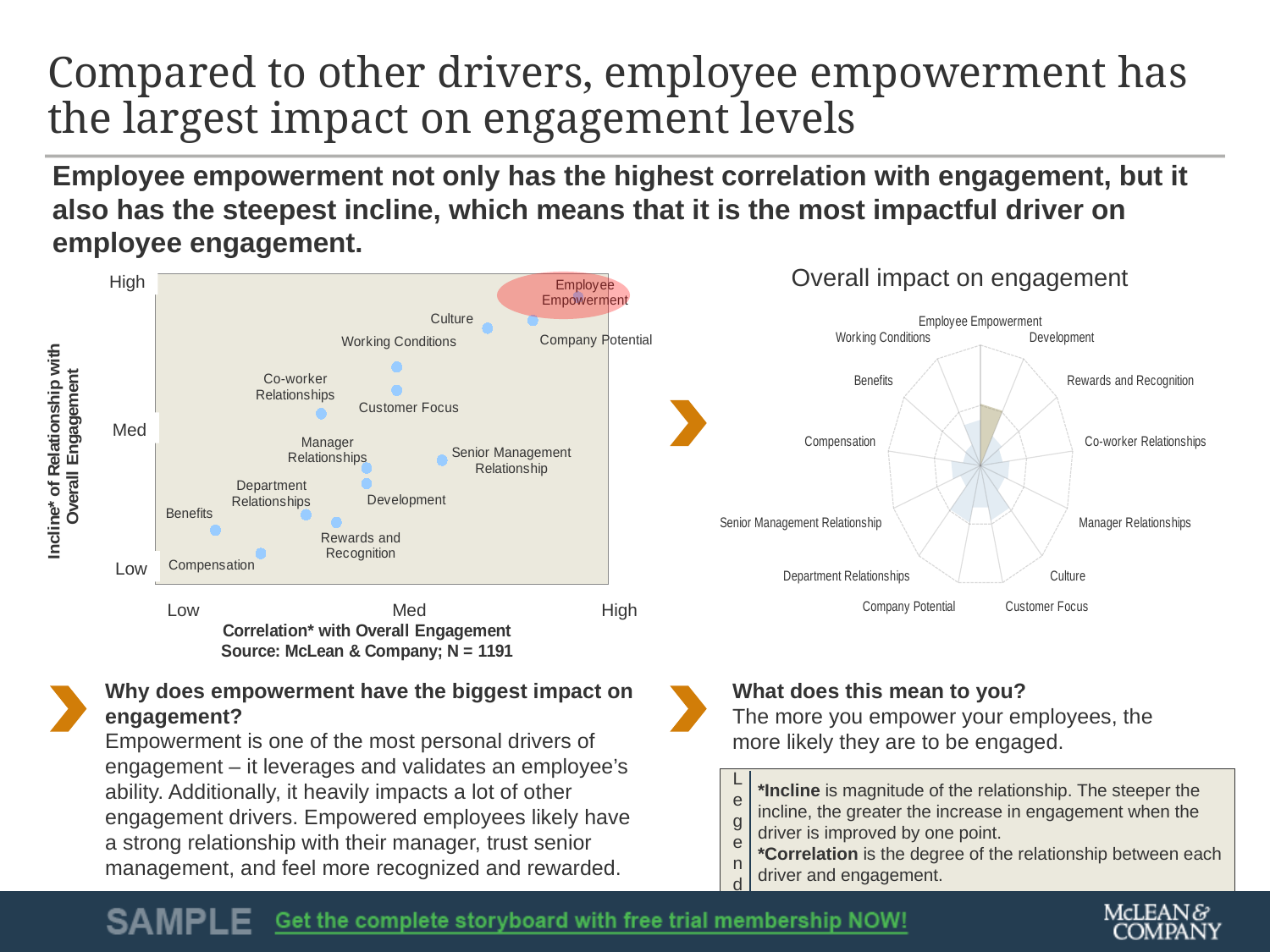
In the left scatter plot, which driver has the lowest incline of relationship with overall engagement? Compensation What kind of chart is the left chart showing incline versus correlation with overall engagement? Scatter plot In the left scatter plot, which has the higher correlation with overall engagement, Culture or Benefits? Culture In the left scatter plot, which driver has the highest incline of relationship with overall engagement? Employee Empowerment In the left scatter plot, which has the higher incline, Working Conditions or Development? Working Conditions In the left scatter plot, which driver has the lowest correlation with overall engagement? Benefits In the left scatter plot, which has the higher correlation with overall engagement, Senior Management Relationship or Department Relationships? Senior Management Relationship What kind of chart is the right chart titled 'Overall impact on engagement'? Radar chart In the right radar chart, which driver has the largest overall impact on engagement? Employee Empowerment In the right radar chart, how many drivers are shown around the chart? 13 What is the sample size (N) given in the source note under the left scatter plot? 1191 In the left scatter plot, how many drivers are plotted as points? 13